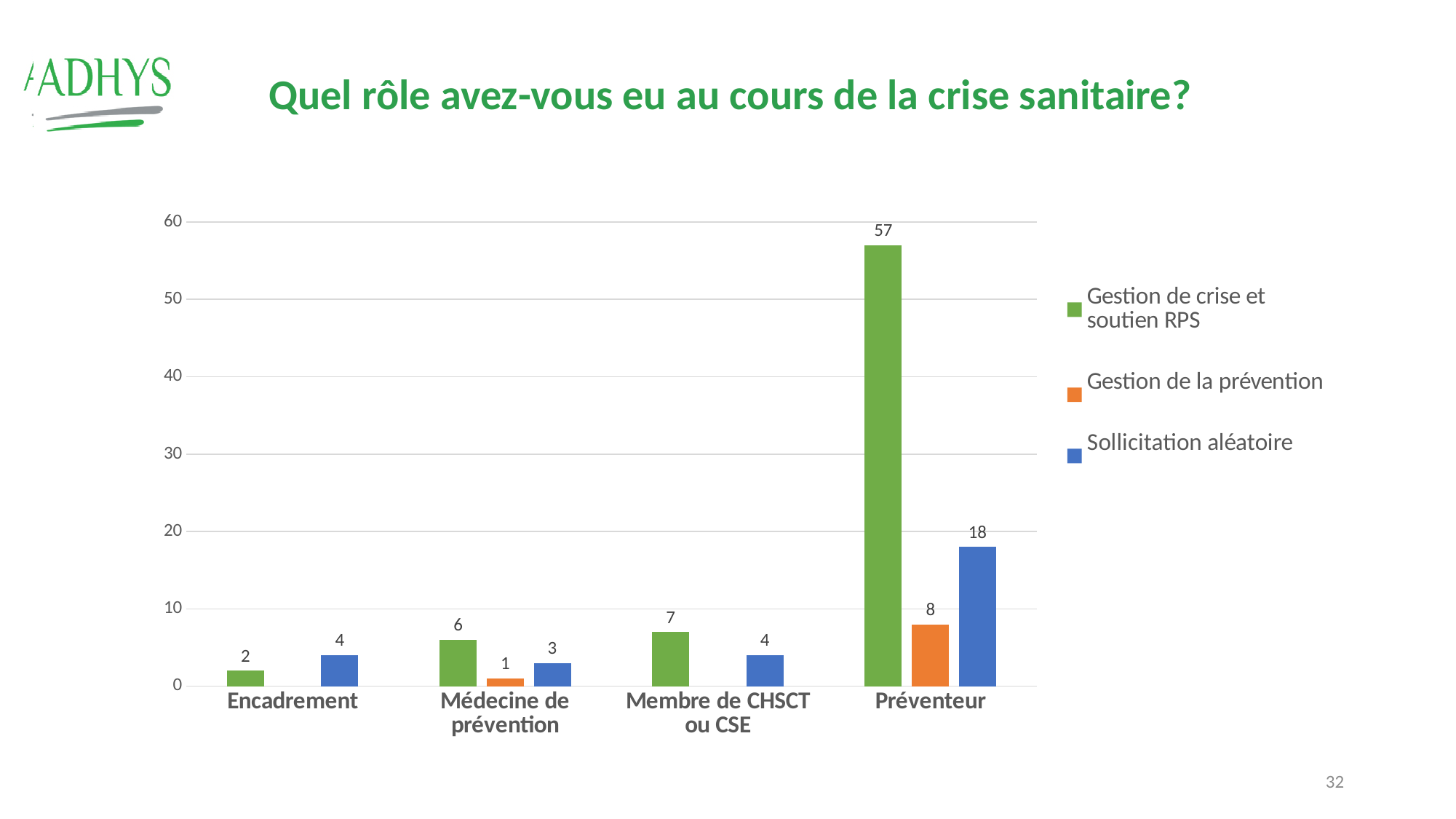
Which category has the highest value in the Sollicitation aléatoire series? Préventeur Which is larger for Médecine de prévention: the Gestion de crise et soutien RPS value or the Sollicitation aléatoire value? Gestion de crise et soutien RPS How many series does the legend list? 3 Which category has the lowest value in the Gestion de crise et soutien RPS series? Encadrement What kind of chart is shown on the slide? bar chart Is the Gestion de crise et soutien RPS value for Préventeur greater or less than 50? greater What is the value for Médecine de prévention in the Gestion de la prévention series? 1 What is the value for Encadrement in the Sollicitation aléatoire series? 4 How many categories are shown on the x axis? 4 What is the value for Préventeur in the Gestion de crise et soutien RPS series? 57 What is the difference between the Gestion de crise et soutien RPS value and the Sollicitation aléatoire value for Préventeur? 39 What is the value for Membre de CHSCT ou CSE in the Gestion de crise et soutien RPS series? 7